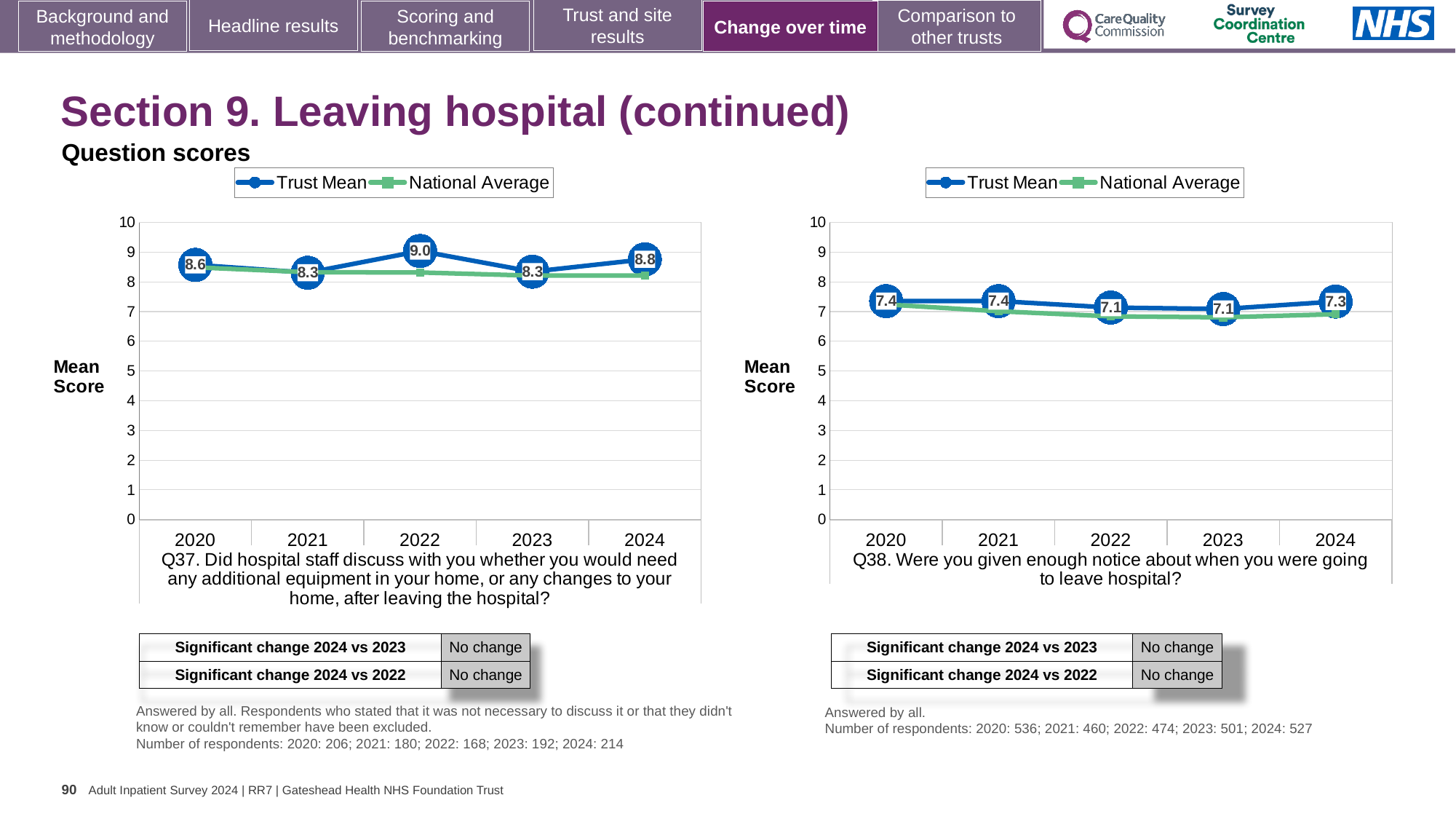
What kind of chart is the Q38 chart on the right? Line chart In the Q38 chart on the right, what is the difference between the Trust Mean scores for 2020 and 2022? 0.3 In the Q37 chart on the left, what is the Trust Mean score for 2022? 9.0 In the Q37 chart on the left, does the Trust Mean rise or fall from 2023 to 2024? Rise In the Q38 chart on the right, what is the Trust Mean score for 2024? 7.3 How many years are shown on the x axis of the Q38 chart on the right? 5 How many series does the legend of the Q37 chart on the left list? 2 In the Q37 chart on the left, which year has the highest Trust Mean score? 2022 In the Q38 chart on the right, is the National Average value for 2023 greater or less than 7? less In the Q37 chart on the left, what is the difference between the Trust Mean scores for 2022 and 2021? 0.7 In the Q37 chart on the left, is the National Average value for 2022 greater or less than 8? greater In the Q37 chart on the left, which is larger: the Trust Mean for 2022 or for 2024? 2022